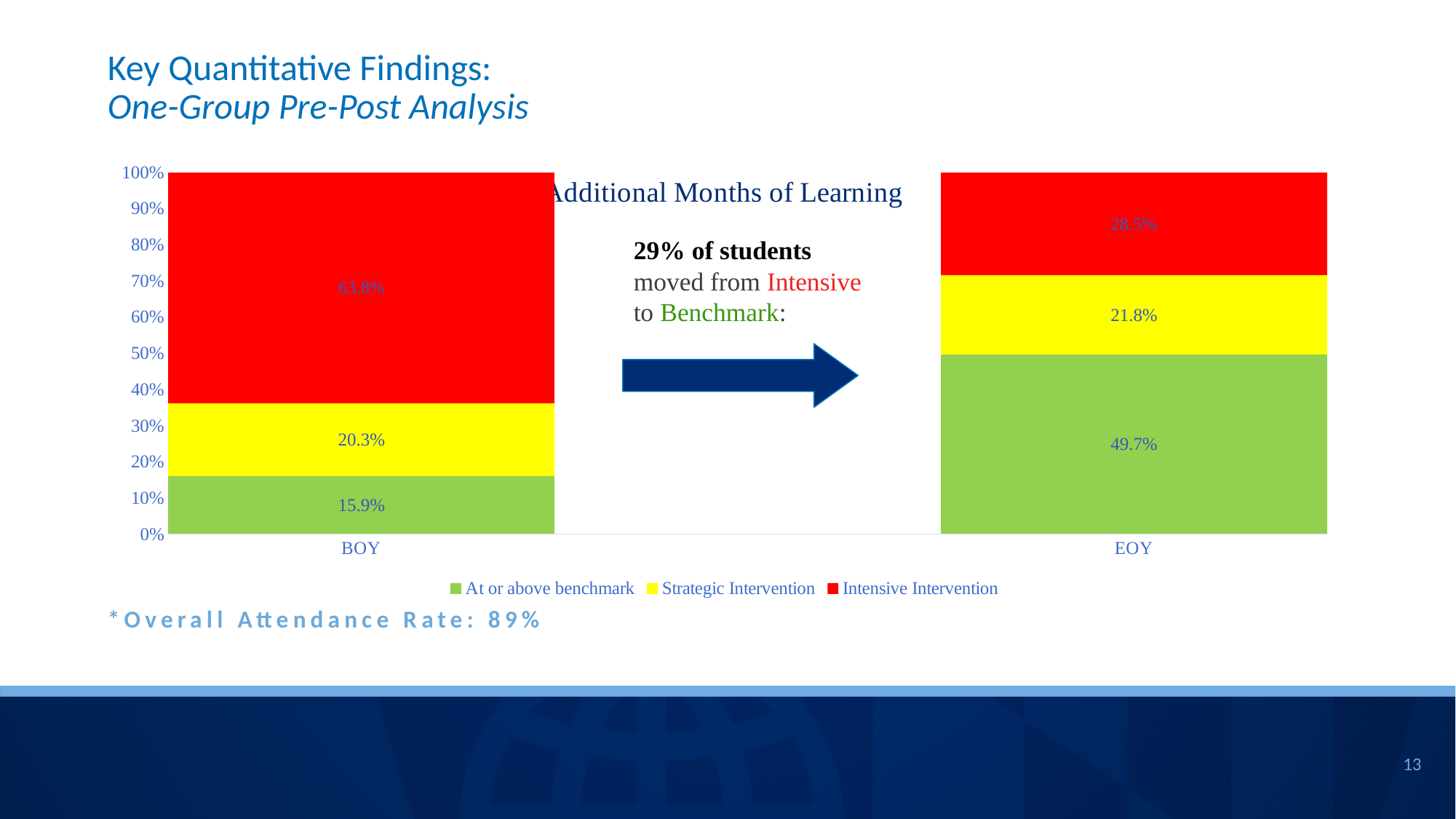
By how much did the Intensive Intervention share fall from BOY to EOY? 35.3% What percentage of students were at or above benchmark at BOY? 15.9% What kind of chart is shown on the slide? Stacked bar chart Which category has the larger Intensive Intervention share, BOY or EOY? BOY What is the Strategic Intervention value for EOY? 21.8% What is the Intensive Intervention value for EOY? 28.5% What percentage of students were at or above benchmark at EOY? 49.7% What is the difference between the At or above benchmark values for EOY and BOY? 33.8% How many categories are shown on the x axis? 2 Which colour represents Strategic Intervention in the chart? Yellow How many series does the legend list? 3 What is the Intensive Intervention value for BOY? 63.8%